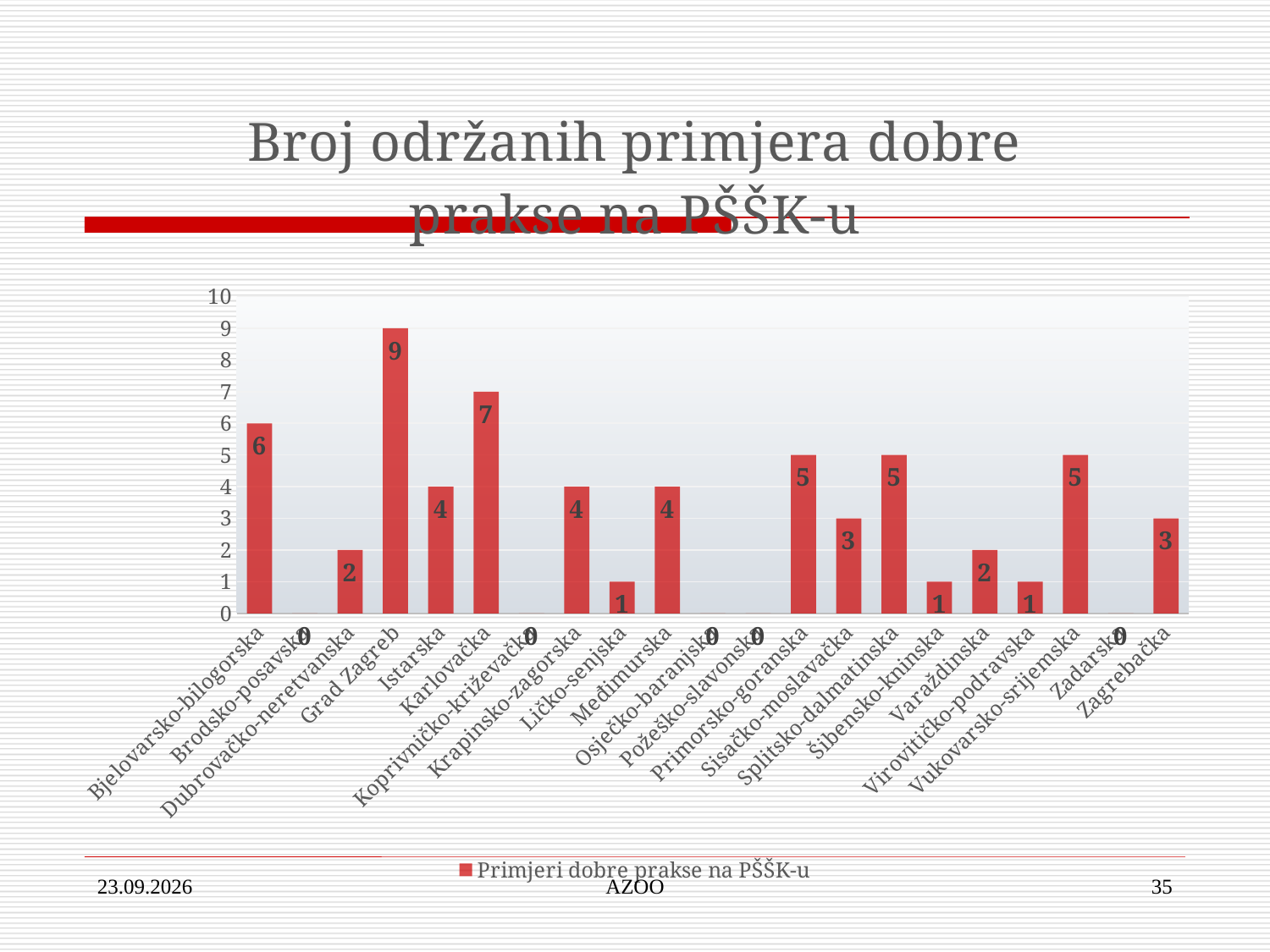
What is the difference between the values for Bjelovarsko-bilogorska and Dubrovačko-neretvanska? 4 Which is larger, the value for Primorsko-goranska or the value for Varaždinska? Primorsko-goranska Is the value for Karlovačka greater or less than 5? greater What is the value for Bjelovarsko-bilogorska? 6 What is the value for Grad Zagreb? 9 What is the value for Karlovačka? 7 What kind of chart is shown on the slide? bar chart How many series does the legend list? 1 How many categories are shown on the x axis? 21 Which category has the highest value? Grad Zagreb What is the value for Sisačko-moslavačka? 3 What is the difference between the values for Grad Zagreb and Karlovačka? 2